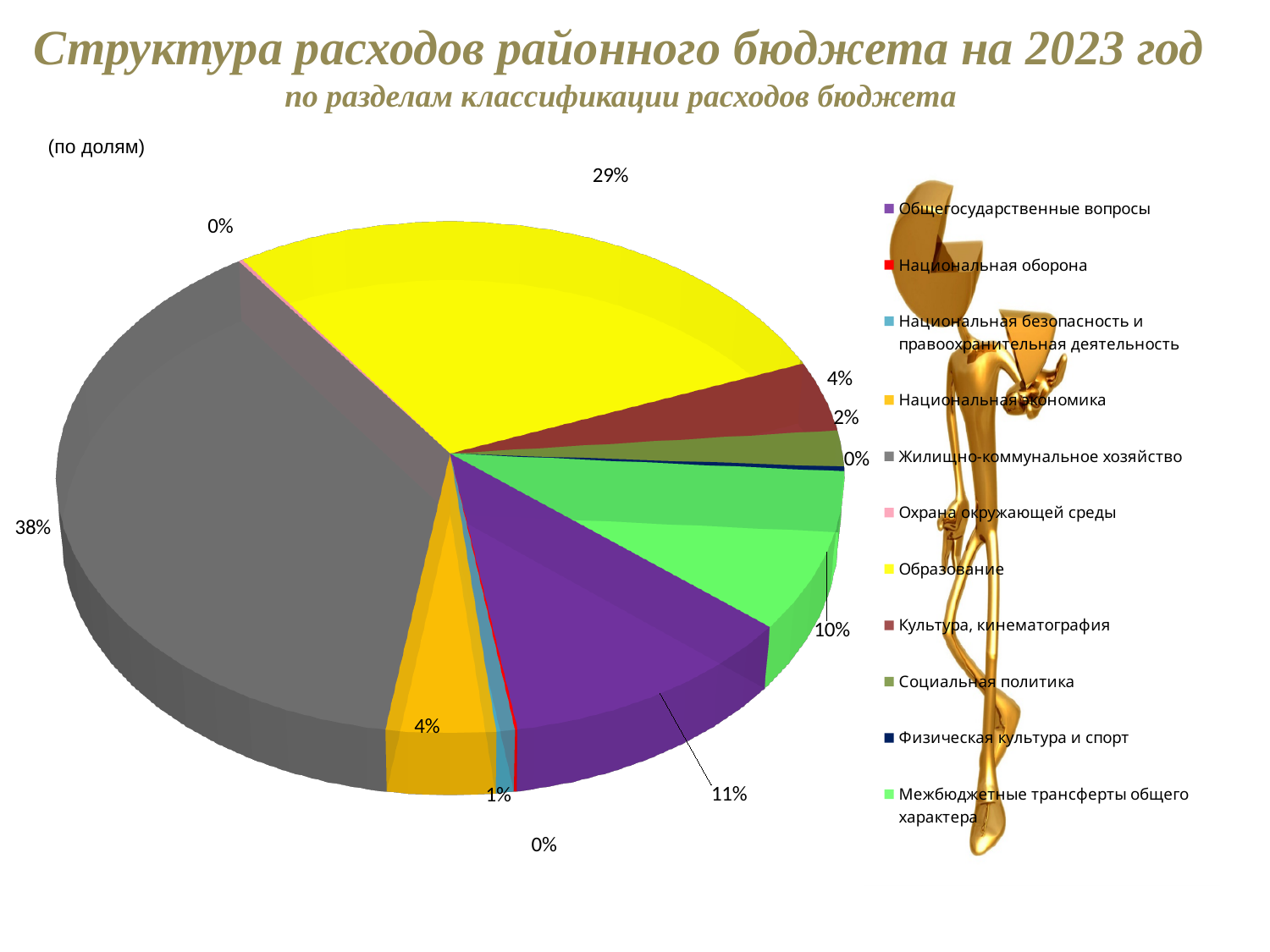
Which is larger, the share for Образование or the share for Общегосударственные вопросы? Образование What share of the pie does Жилищно-коммунальное хозяйство have? 38% What kind of chart is shown on the slide? pie chart What colour is the slice for Образование? yellow How many categories does the legend of the pie chart list? 11 What share of the pie does Межбюджетные трансферты общего характера have? 10% Which category has the largest share of the pie? Жилищно-коммунальное хозяйство What share of the pie does Общегосударственные вопросы have? 11% What is the difference between the share for Жилищно-коммунальное хозяйство and the share for Образование? 9%